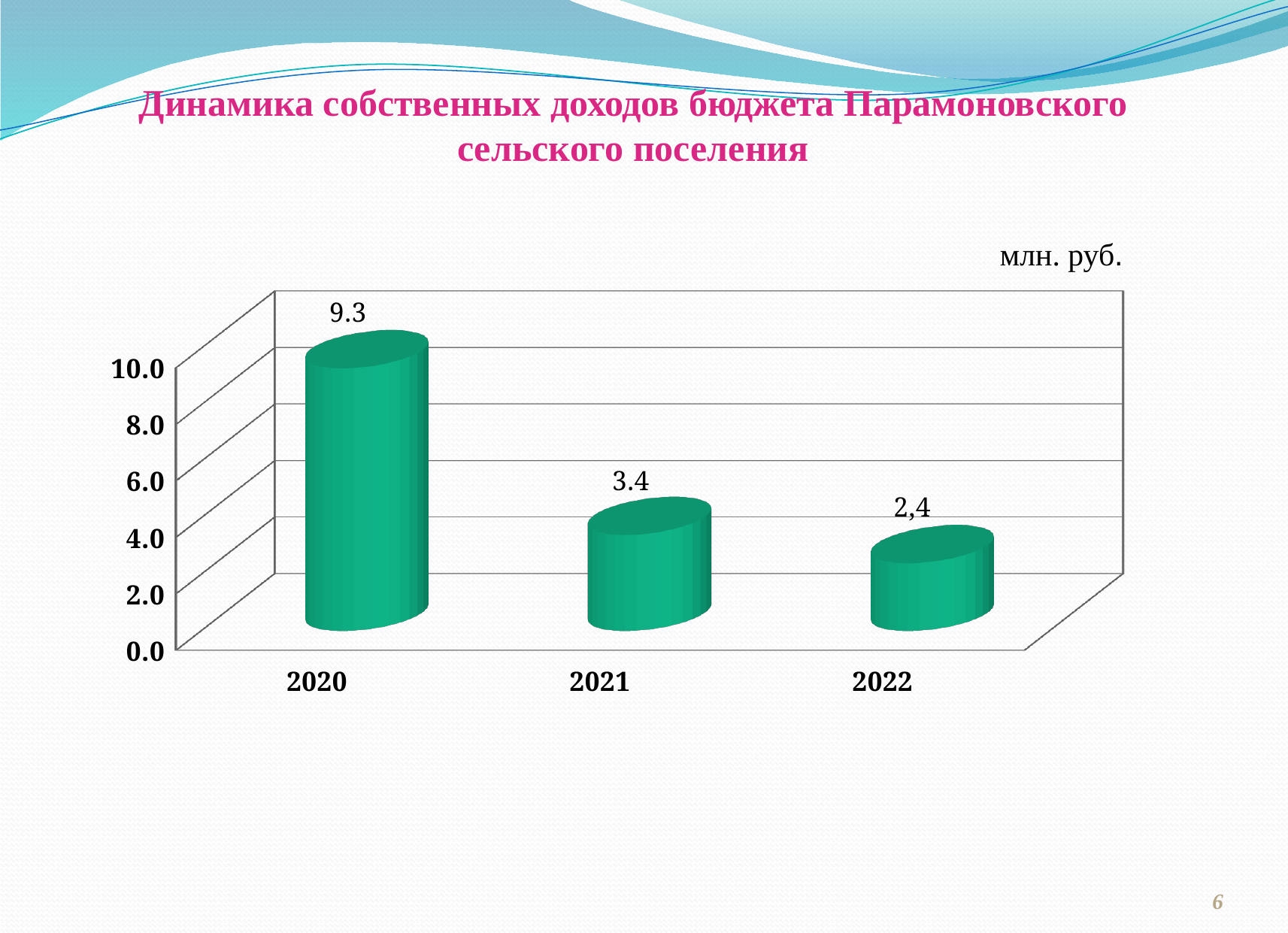
What unit is indicated above the chart? млн. руб. What is the value for 2022? 2,4 Which year has the lowest value? 2022 What is the value for 2021? 3.4 What kind of chart is shown on the slide? bar chart How many years are shown on the x axis? 3 What is the value for 2020? 9.3 Which is larger, the value for 2021 or the value for 2022? 2021 Which year has the highest value? 2020 Do the values rise or fall from 2020 to 2022? fall What is the difference between the values for 2020 and 2021? 5.9 Is the value for 2020 greater or less than 8.0? greater